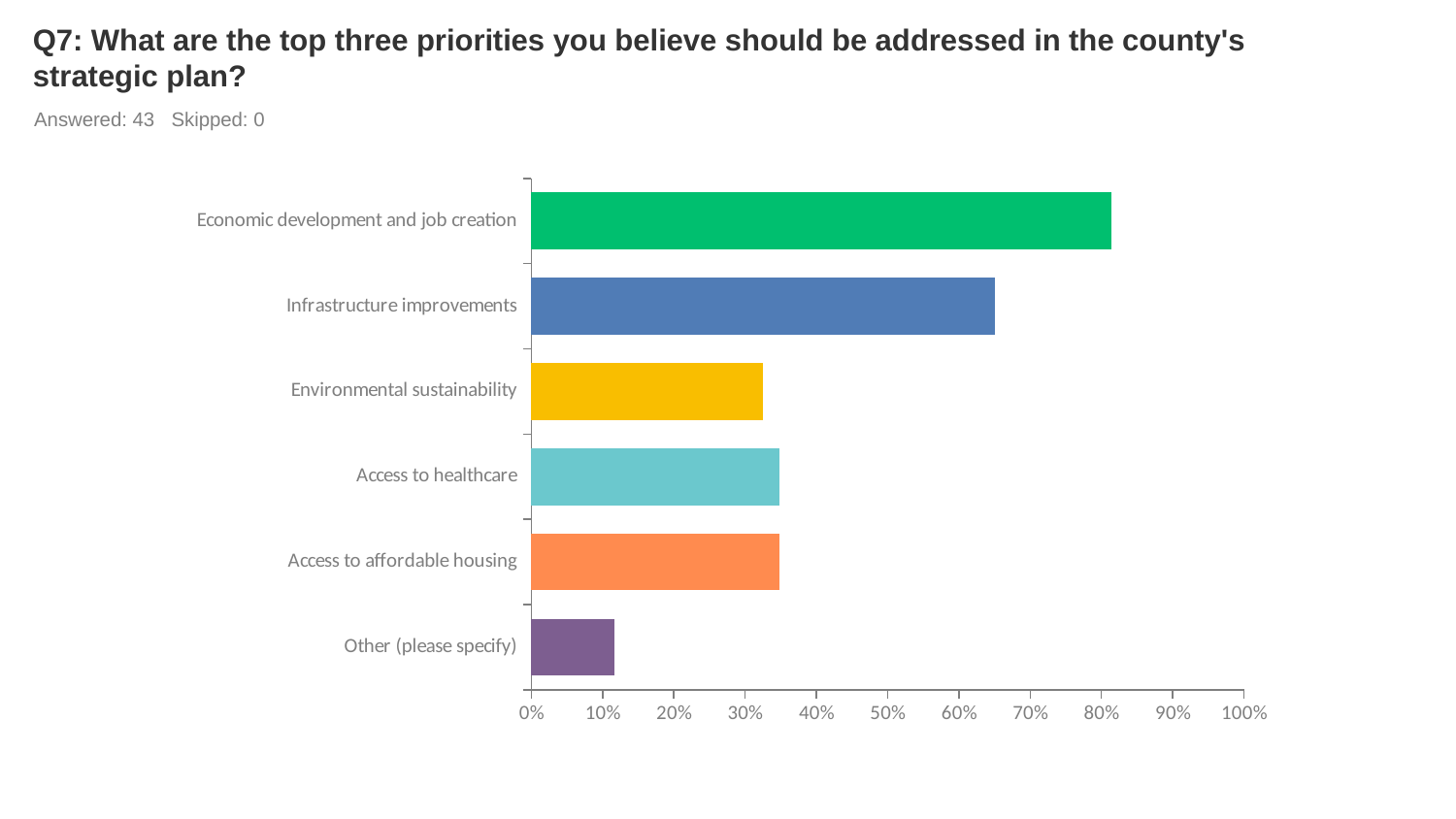
Which category has the lowest value? Other (please specify) How many respondents answered this question according to the slide? 43 What kind of chart is shown on the slide? bar chart How many categories are plotted in the chart? 6 Is the value for Other (please specify) greater or less than 20%? less What is the maximum value shown on the horizontal axis? 100% Is the value for Access to healthcare greater or less than 30%? greater Which is larger, the value for Infrastructure improvements or the value for Access to affordable housing? Infrastructure improvements Is the value for Economic development and job creation greater or less than 80%? greater Which category has the highest value? Economic development and job creation